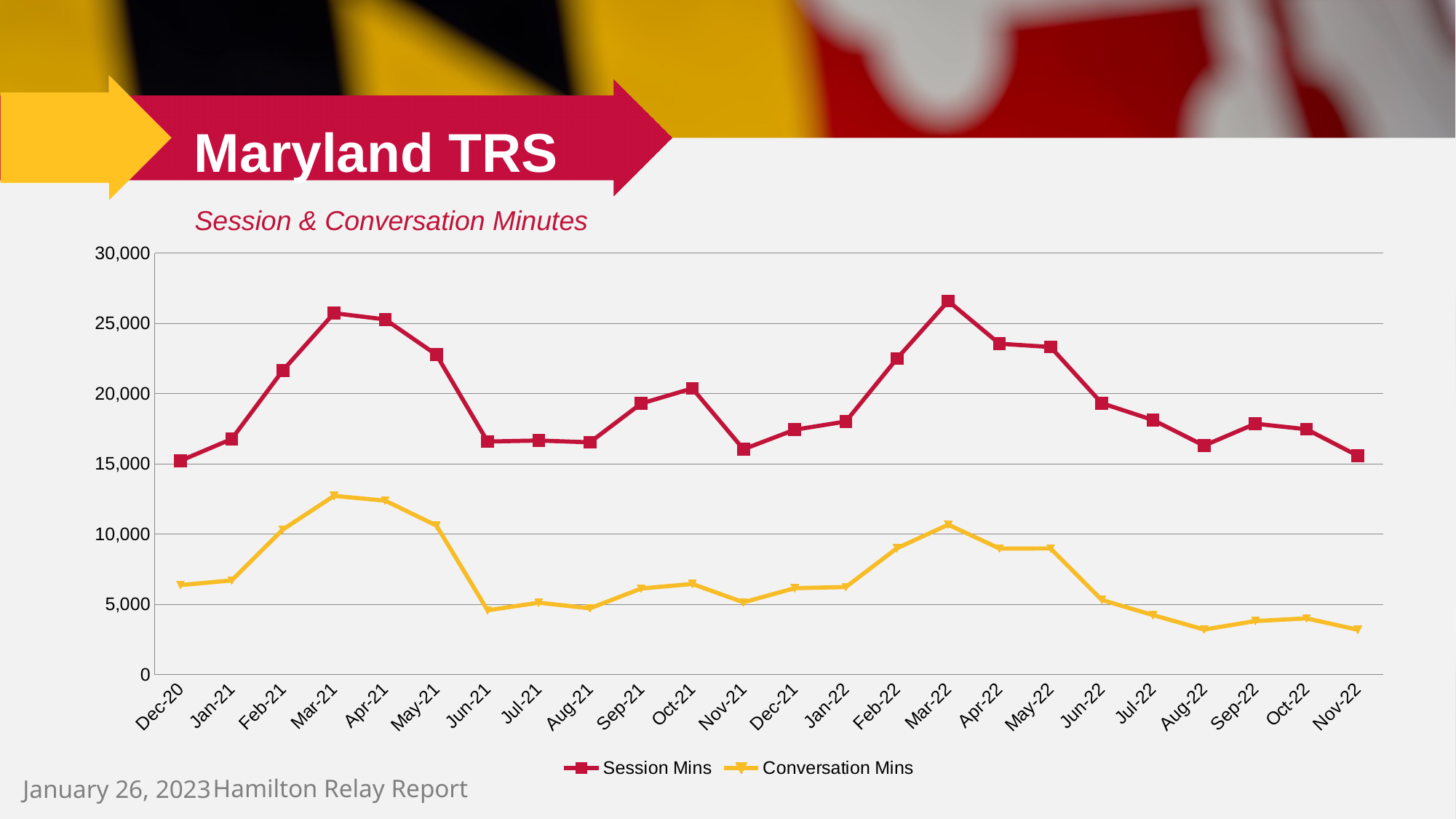
Which is larger for Conversation Mins: Mar-21 or Mar-22? Mar-21 What kind of chart is shown on the slide? Line chart Is the Conversation Mins value for Mar-21 greater or less than 10,000? greater In which month does Session Mins reach its highest value? Mar-22 What is the subtitle of the chart? Session & Conversation Minutes Is the Session Mins value for Mar-21 greater or less than 25,000? greater Is the Session Mins value for Feb-21 greater or less than 20,000? greater How many series does the legend list? 2 Do Session Mins rise or fall from Mar-22 to Nov-22? Fall Which is larger for Session Mins: Oct-21 or Nov-21? Oct-21 How many months are plotted along the x axis? 24